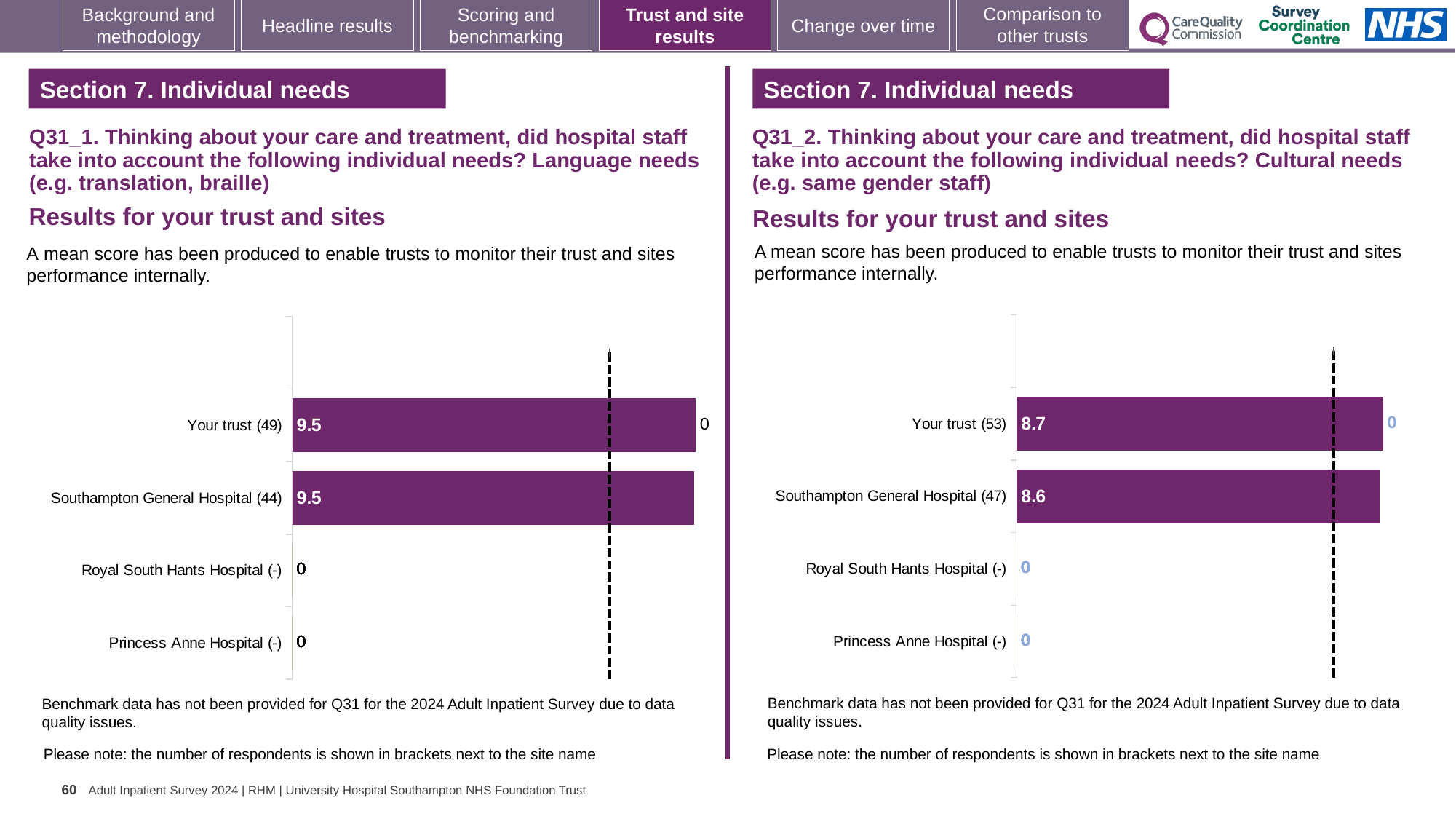
In the Q31_2 Cultural needs chart on the right, what is the mean score for Your trust? 8.7 In the Q31_1 Language needs chart on the left, what is the difference between the scores for Your trust and Southampton General Hospital? 0 What type of chart is used for the Q31_2 Cultural needs results on the right? Bar chart In the Q31_2 Cultural needs chart on the right, what is the mean score for Southampton General Hospital? 8.6 In the Q31_2 Cultural needs chart on the right, what is the difference between the scores for Your trust and Southampton General Hospital? 0.1 Which is higher in the Q31_2 Cultural needs chart on the right: Your trust or Southampton General Hospital? Your trust In the Q31_2 Cultural needs chart on the right, how many respondents are shown in brackets for Southampton General Hospital? 47 In the Q31_1 Language needs chart on the left, what is the mean score for Southampton General Hospital? 9.5 In the Q31_1 Language needs chart on the left, what is the mean score for Your trust? 9.5 In the Q31_1 Language needs chart on the left, how many respondents are shown in brackets for Your trust? 49 How many site categories are listed on the y axis of the Q31_1 Language needs chart on the left? 4 Is the score for Your trust in the Q31_1 Language needs chart on the left higher or lower than the score for Your trust in the Q31_2 Cultural needs chart on the right? Higher